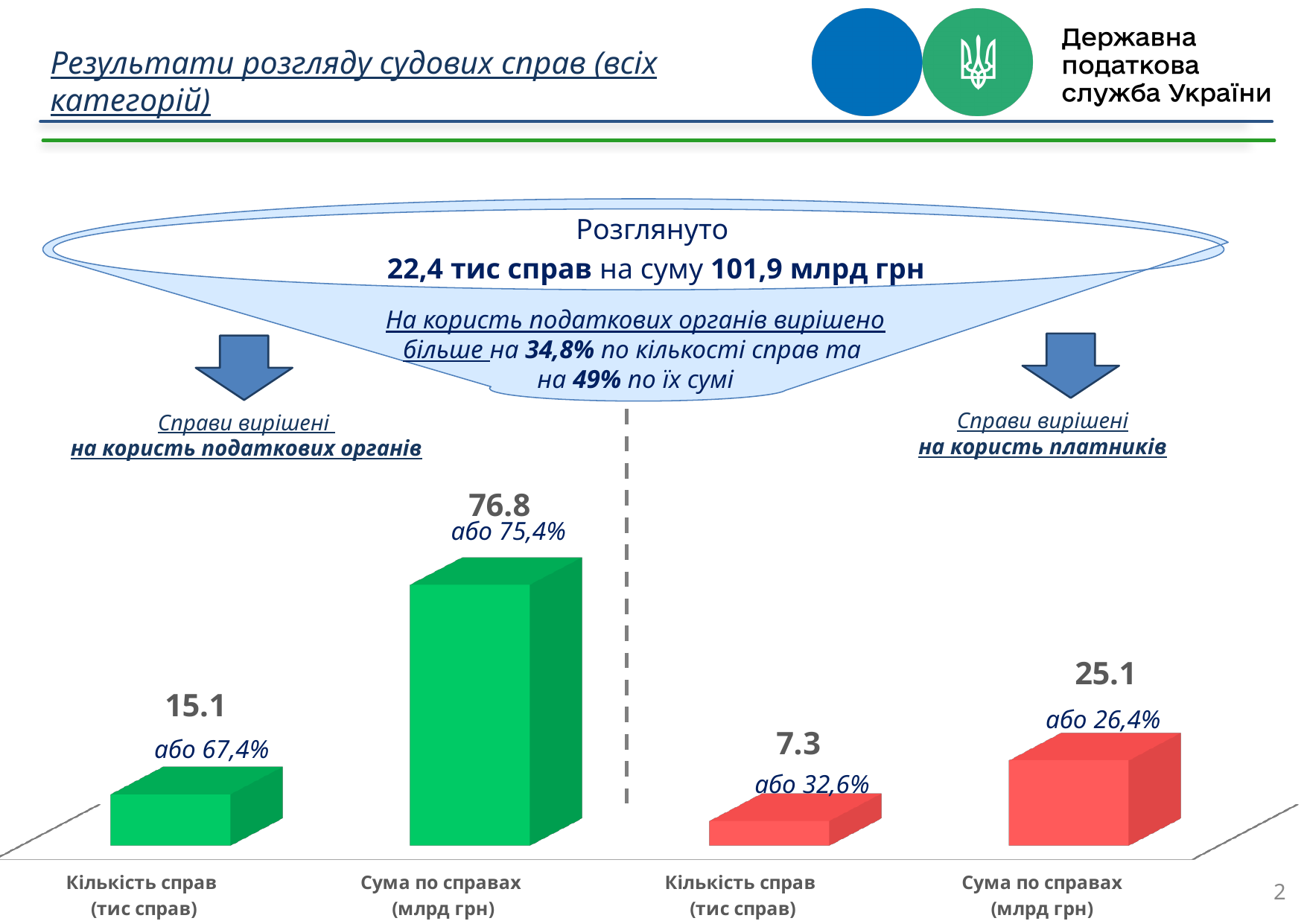
What percentage share is printed next to the 7.3 bar? 32,6% Which bar has the lowest value on the chart? Кількість справ (тис справ) на користь платників (7.3) What is the difference between the 'Сума по справах' values for the tax authorities (76.8) and for taxpayers (25.1)? 51.7 What type of chart is shown on the slide? bar chart What is the value of the bar for 'Сума по справах (млрд грн)' among cases decided in favour of the tax authorities ('на користь податкових органів')? 76.8 What colour are the bars for cases decided in favour of taxpayers ('на користь платників')? red What is the value of the bar for 'Кількість справ (тис справ)' among cases decided in favour of the tax authorities ('на користь податкових органів')? 15.1 How many bars are plotted on the chart? 4 Which bar has the highest value on the chart? Сума по справах (млрд грн) на користь податкових органів (76.8) What is the value of the bar for 'Сума по справах (млрд грн)' among cases decided in favour of taxpayers ('на користь платників')? 25.1 What is the value of the bar for 'Кількість справ (тис справ)' among cases decided in favour of taxpayers ('на користь платників')? 7.3 What percentage share is printed next to the 76.8 bar? 75,4%